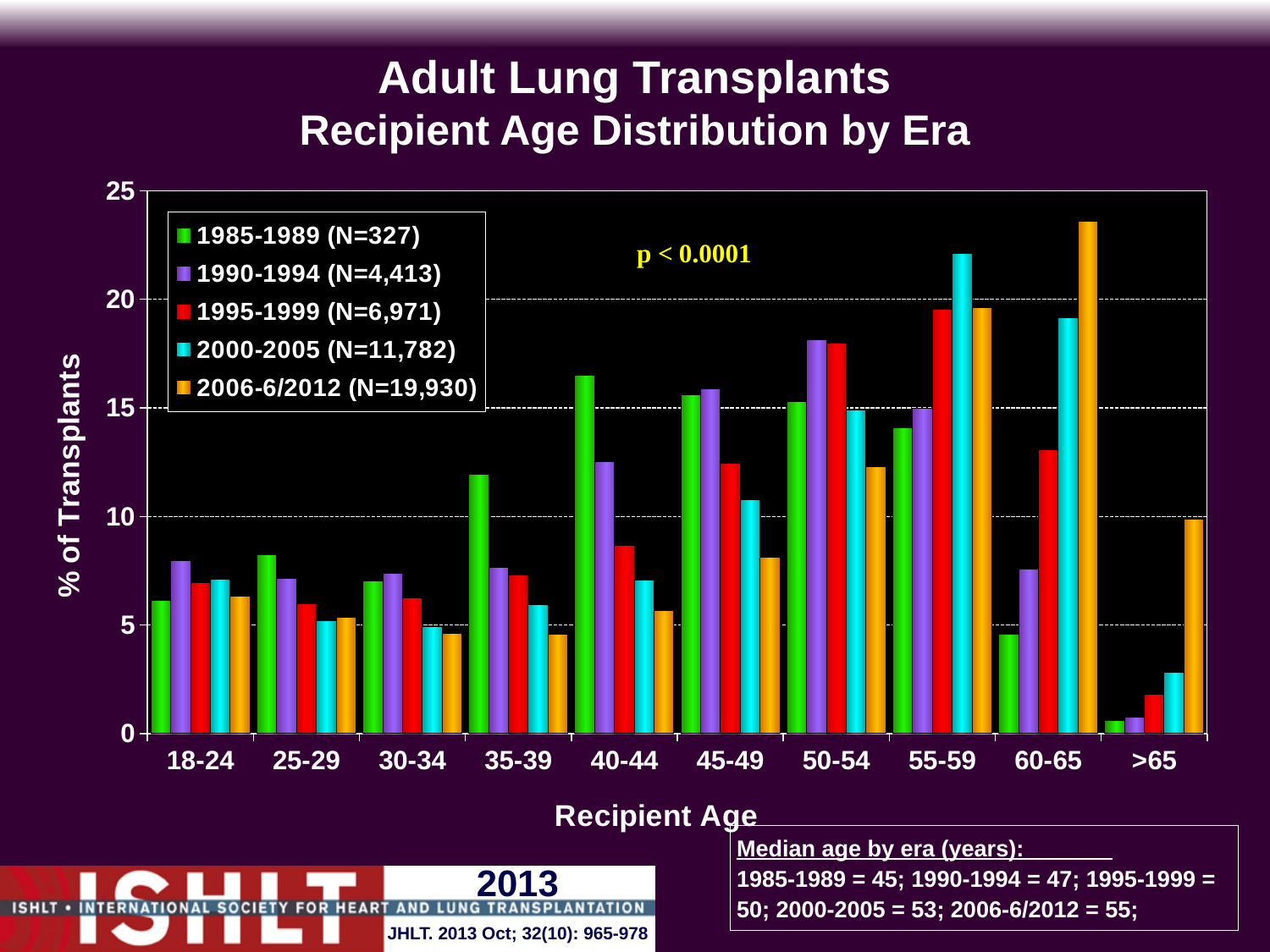
For the 1985-1989 era, which recipient age group has the highest percentage of transplants? 40-44 Is the value for the 2000-2005 era in the 55-59 age group greater or less than 20? greater What kind of chart is shown on the slide? Bar chart Is the value for the 1985-1989 era in the 35-39 age group greater or less than 10? greater How many series (eras) does the legend list? 5 For the 2006-6/2012 era, do the values rise or fall from the 30-34 age group to the 60-65 age group? Rise In the 60-65 age group, which era has the larger percentage of transplants: 1985-1989 or 2006-6/2012? 2006-6/2012 For the 2006-6/2012 era, which recipient age group has the highest percentage of transplants? 60-65 How many recipient age groups are shown on the x axis? 10 For the 2000-2005 era, which recipient age group has the lowest percentage of transplants? >65 What p value is printed on the chart? p < 0.0001